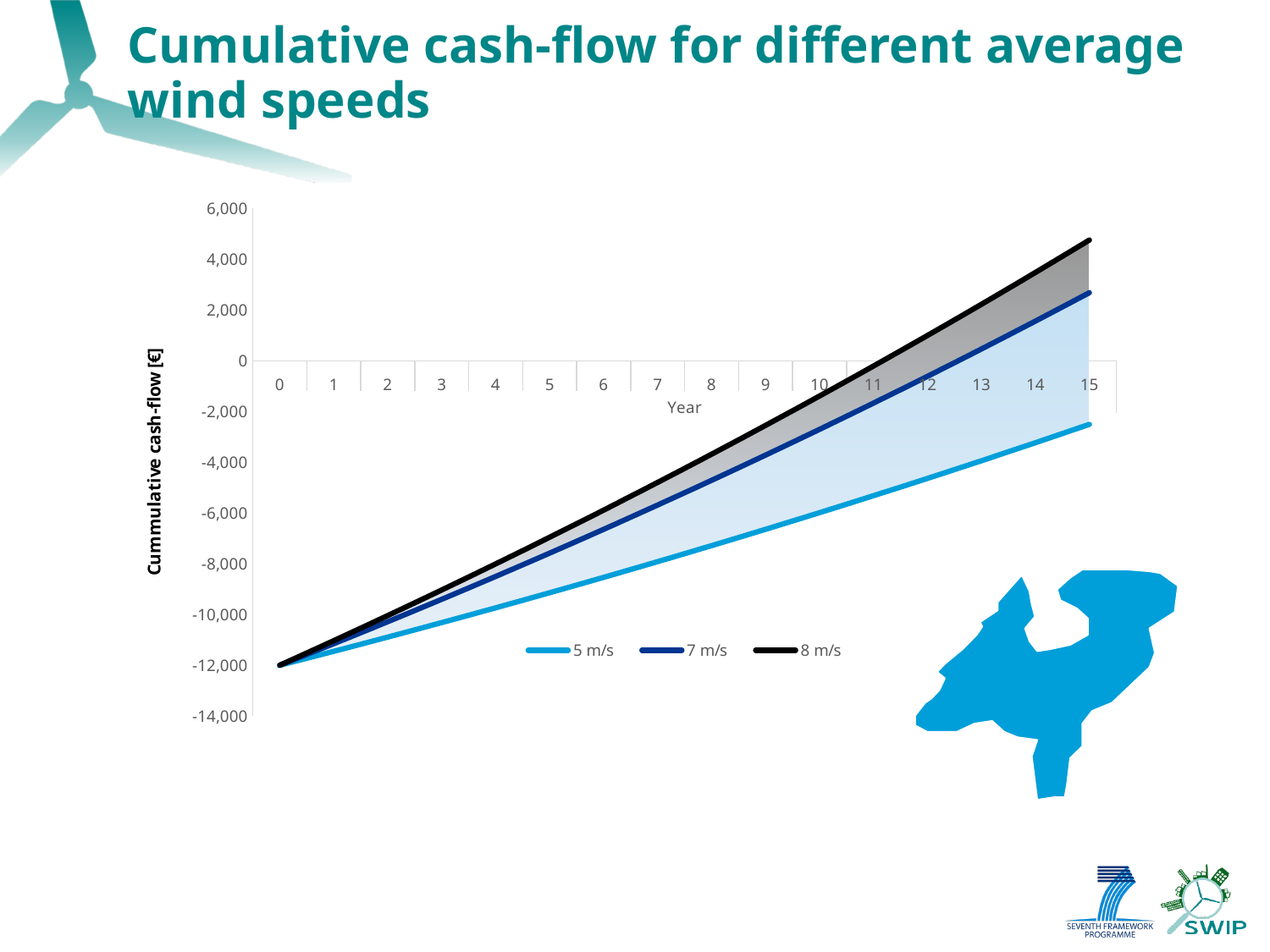
Do the cumulative cash-flow values rise or fall as the year increases? rise What is the title of the chart? Cumulative cash-flow for different average wind speeds What is the cumulative cash-flow for all three series at year 0? -12,000 At year 15, which is larger: the cumulative cash-flow for 7 m/s or for 5 m/s? 7 m/s Which series has the lowest cumulative cash-flow at year 15? 5 m/s Is the cumulative cash-flow for 7 m/s at year 15 greater or less than 2,000? greater What is the label of the x axis? Year How many series does the legend list? 3 Which series has the highest cumulative cash-flow at year 15? 8 m/s Is the cumulative cash-flow for 8 m/s at year 15 greater or less than 4,000? greater What kind of chart is shown on the slide? line chart Is the cumulative cash-flow for 5 m/s at year 15 greater or less than 0? less